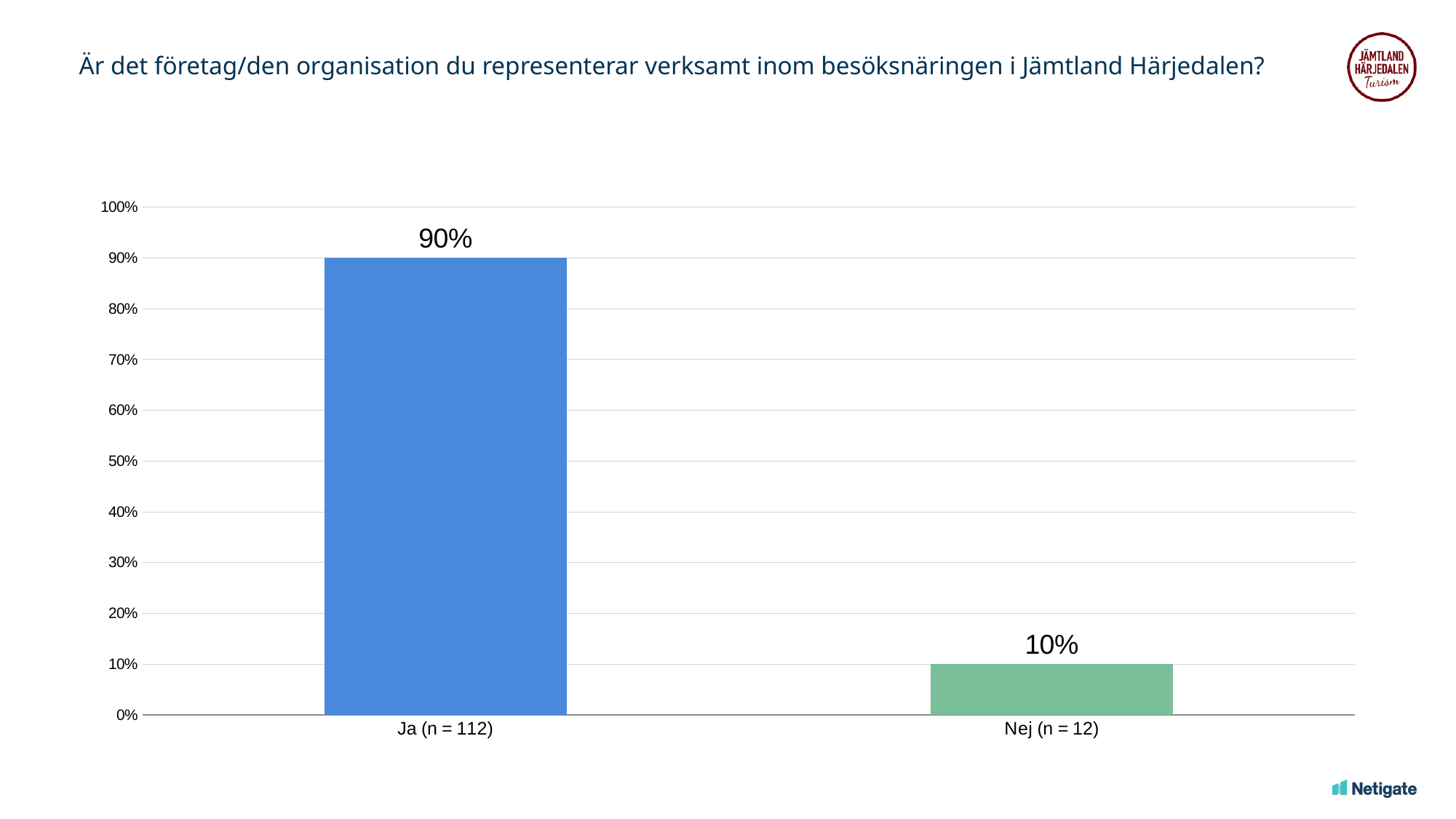
Is the value for Nej (n = 12) greater or less than 20%? less What kind of chart is shown on the slide? bar chart Which is larger, the value for Ja (n = 112) or the value for Nej (n = 12)? Ja (n = 112) What is the difference between the values for Ja (n = 112) and Nej (n = 12)? 80% Which category has the highest value? Ja (n = 112) What is the value for Ja (n = 112)? 90% Is the value for Ja (n = 112) greater or less than 50%? greater Which category has the lowest value? Nej (n = 12) How many categories are shown on the x axis? 2 What colour is the bar for Nej (n = 12)? green What is the value for Nej (n = 12)? 10% What is the highest value shown on the y axis? 100%